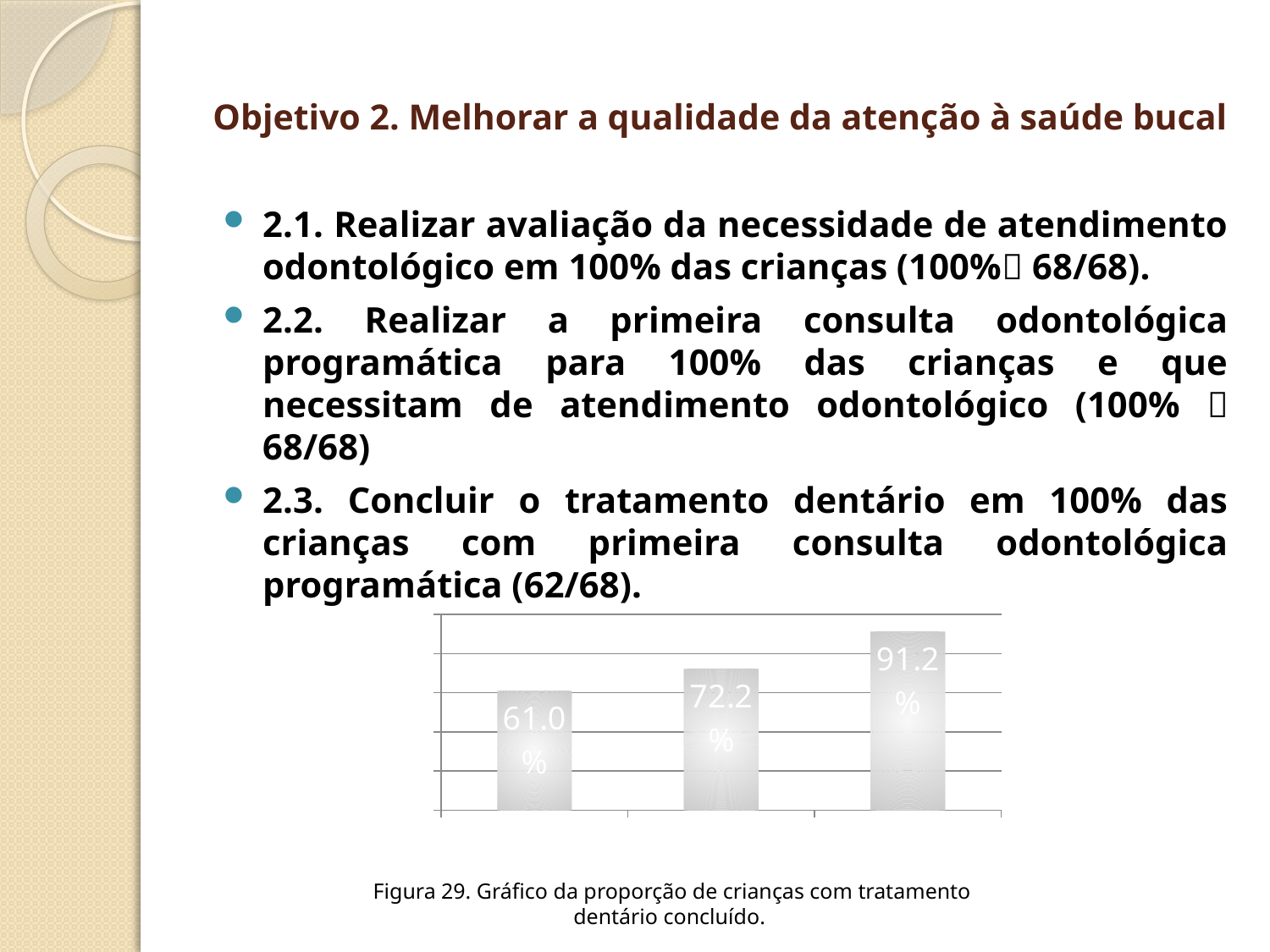
Which is larger, the value of the middle bar or the value of the rightmost bar? the rightmost bar (91.2%) What is the difference between the middle bar and the leftmost bar in the chart? 11.2% What is the value shown on the middle bar of the chart? 72.2% What is the difference between the rightmost bar and the leftmost bar in the chart? 30.2% Which bar has the highest value in the chart? the third (rightmost) bar, 91.2% According to the caption, what does the chart (Figura 29) show? Gráfico da proporção de crianças com tratamento dentário concluído What is the value shown on the first (leftmost) bar of the chart? 61.0% Which bar has the lowest value in the chart? the first (leftmost) bar, 61.0% How many bars are plotted in the chart? 3 What is the value shown on the third (rightmost) bar of the chart? 91.2% What type of chart is shown on the slide? bar chart Do the values rise or fall from left to right across the chart? rise